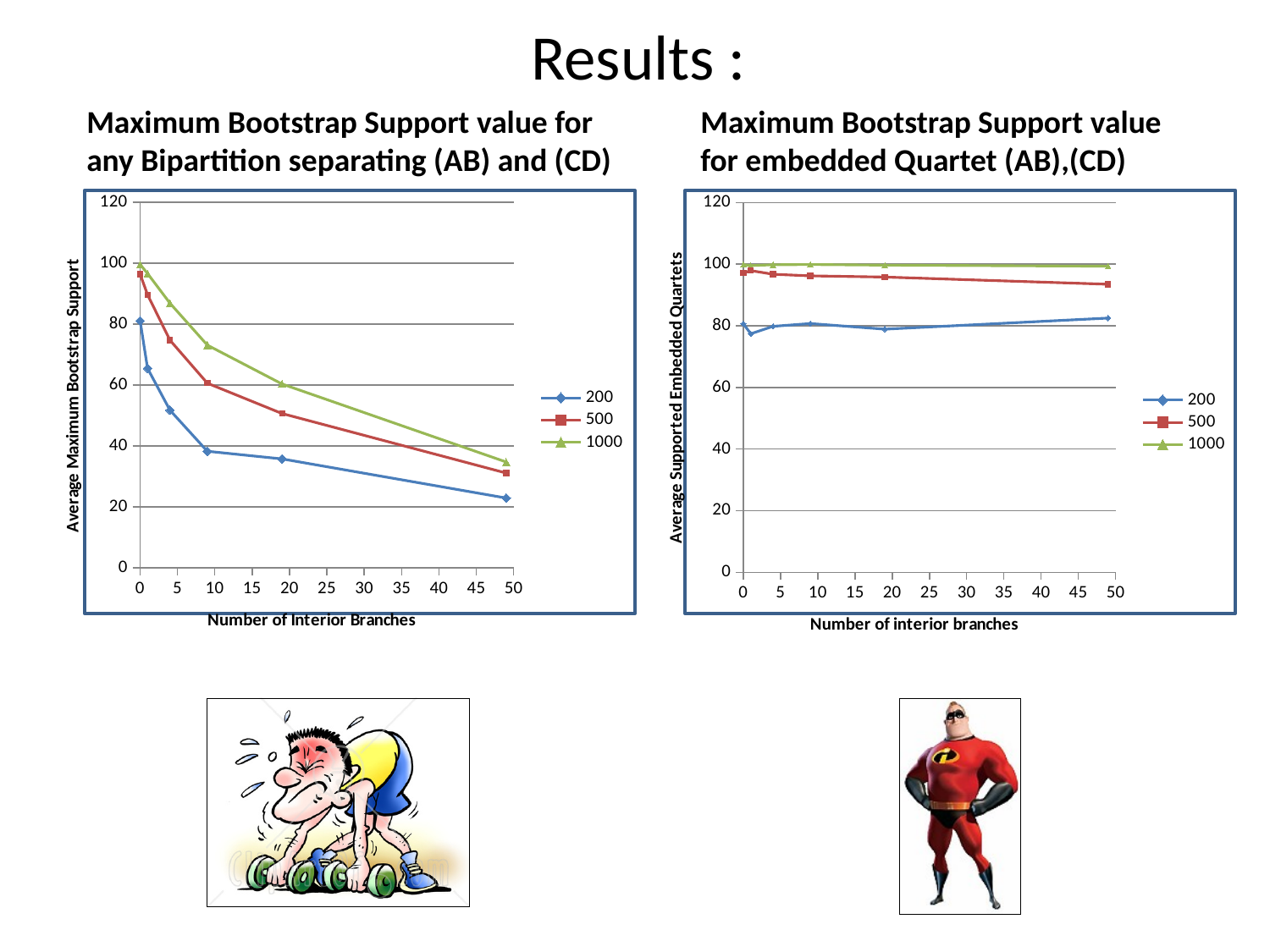
What type of chart is the left chart, 'Maximum Bootstrap Support value for any Bipartition separating (AB) and (CD)'? Line chart How many series does the legend of the right chart list? 3 What is the x-axis label of the right chart? Number of interior branches In the right chart, is the value of the 200 series at about 19 interior branches greater or less than 60? greater In the left chart, do the values of the 200 series rise or fall as the number of interior branches increases? Fall How many series does the legend of the left chart list? 3 What type of chart is the right chart, 'Maximum Bootstrap Support value for embedded Quartet (AB),(CD)'? Line chart In the left chart, is the value of the 200 series at about 49 interior branches greater or less than 40? less In the left chart, at about 49 interior branches, which series has the higher value: 1000 or 200? 1000 In the right chart, which series has the lowest values across the number of interior branches? 200 What is the y-axis label of the left chart? Average Maximum Bootstrap Support In the left chart, is the value of the 200 series at 0 interior branches greater or less than 60? greater